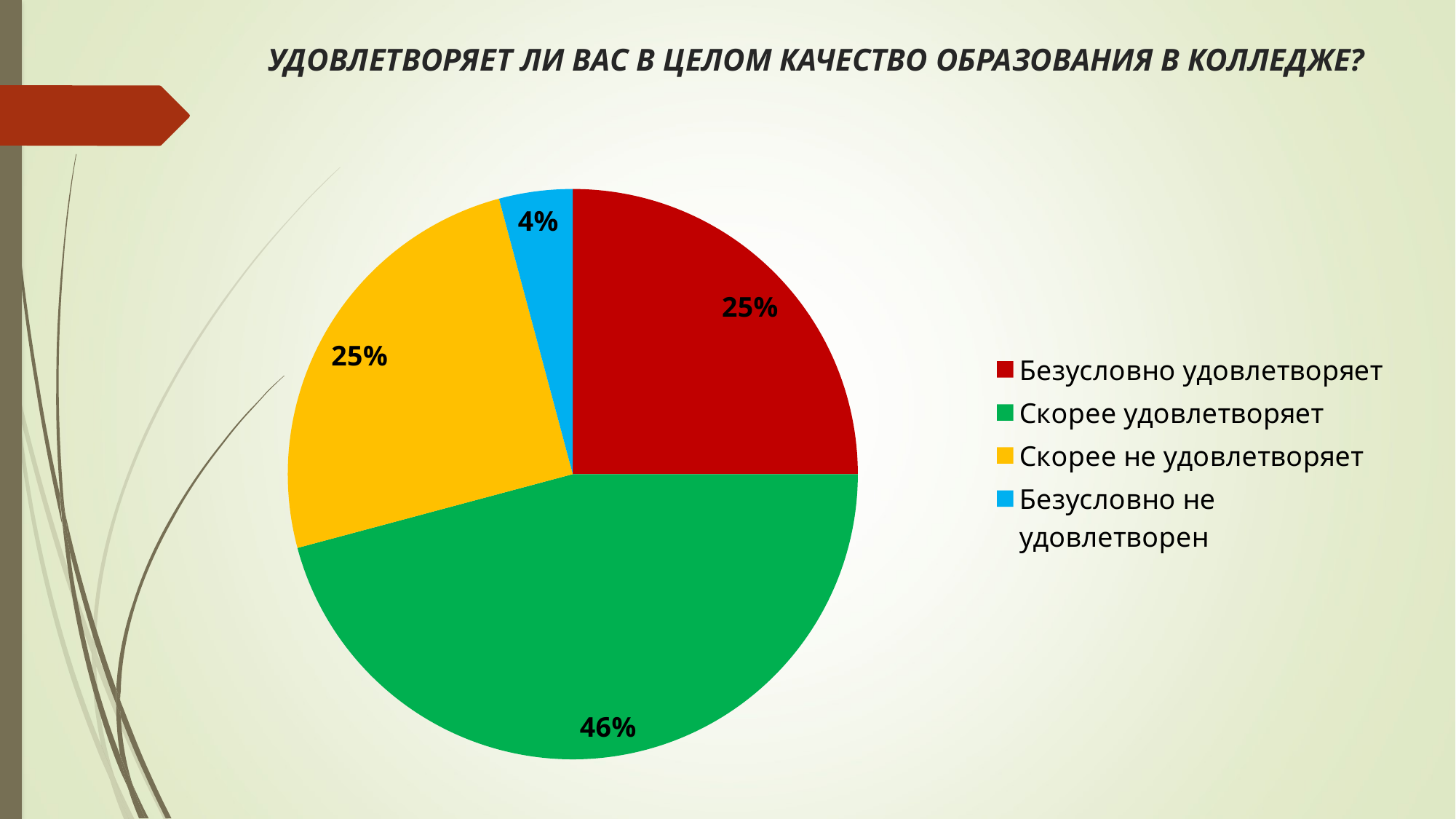
What colour is the slice for "Скорее не удовлетворяет"? yellow What share of the pie does "Скорее не удовлетворяет" have? 25% What is the title of the chart? УДОВЛЕТВОРЯЕТ ЛИ ВАС В ЦЕЛОМ КАЧЕСТВО ОБРАЗОВАНИЯ В КОЛЛЕДЖЕ? Which category has the largest slice of the pie? Скорее удовлетворяет Which category has the smallest slice of the pie? Безусловно не удовлетворен What share of the pie does "Безусловно удовлетворяет" have? 25% What share of the pie does "Скорее удовлетворяет" have? 46% What type of chart is shown on the slide? pie chart Which is larger: the slice for "Скорее удовлетворяет" or the slice for "Безусловно удовлетворяет"? Скорее удовлетворяет What is the difference in percentage points between "Скорее удовлетворяет" and "Безусловно не удовлетворен"? 42 How many categories does the pie chart have? 4